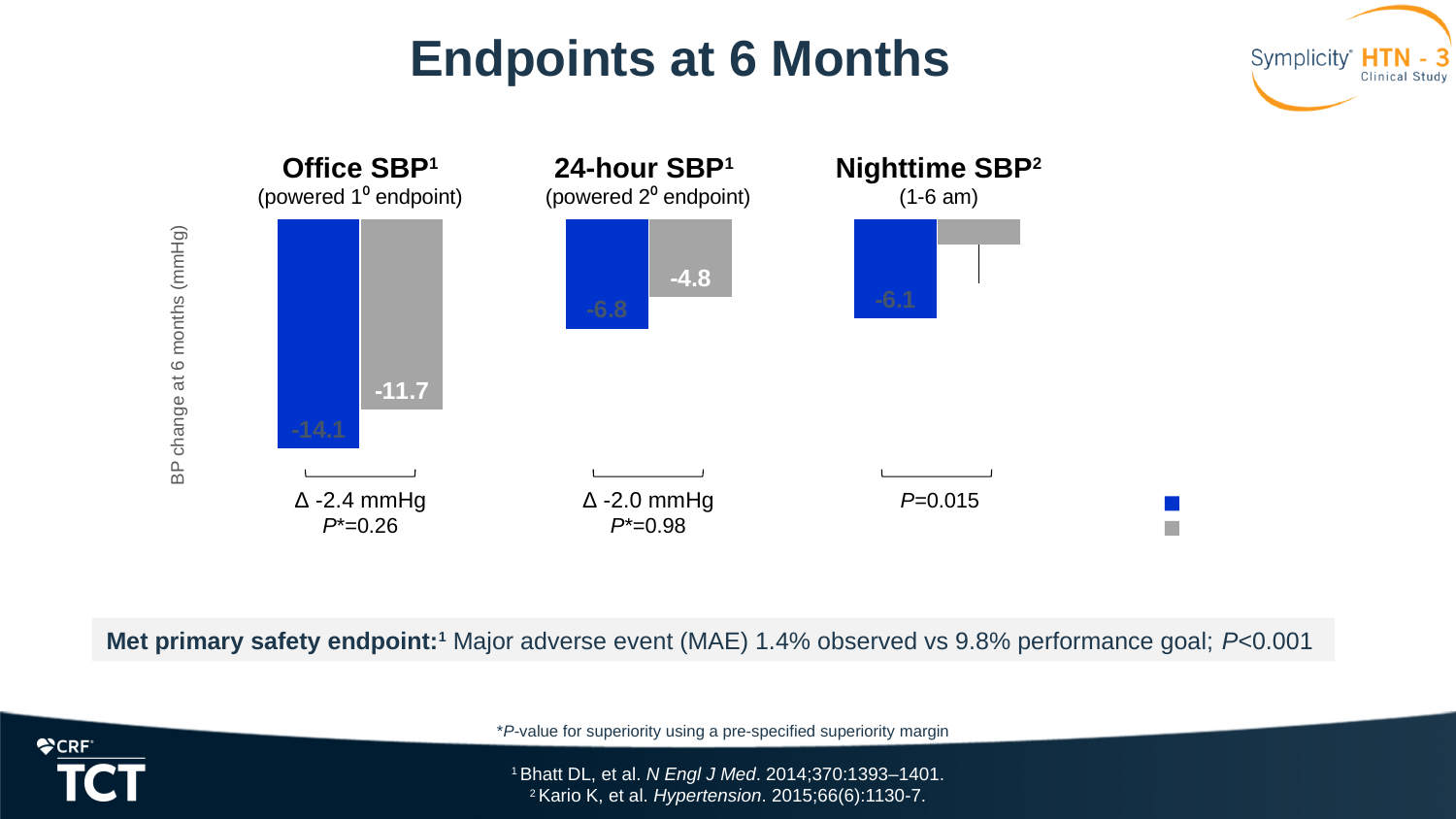
How many bars are shown in the 24-hour SBP chart? 2 What is the value of the gray bar in the 24-hour SBP chart? -4.8 What is the value of the blue bar in the 24-hour SBP chart? -6.8 What is the label of the vertical axis on the left of the charts? BP change at 6 months (mmHg) What is the value of the gray bar in the Office SBP chart? -11.7 In the Office SBP chart, which bar shows the larger BP reduction, the blue bar or the gray bar? the blue bar What is the value of the blue bar in the Office SBP chart? -14.1 In the 24-hour SBP chart, what is the difference between the blue bar (-6.8) and the gray bar (-4.8)? -2.0 mmHg In the Office SBP chart, what is the difference between the blue bar (-14.1) and the gray bar (-11.7)? -2.4 mmHg What is the value of the blue bar in the Nighttime SBP chart? -6.1 Across the three charts, which endpoint has the blue bar with the largest BP reduction? Office SBP What kind of chart is used to show the endpoints at 6 months? bar chart